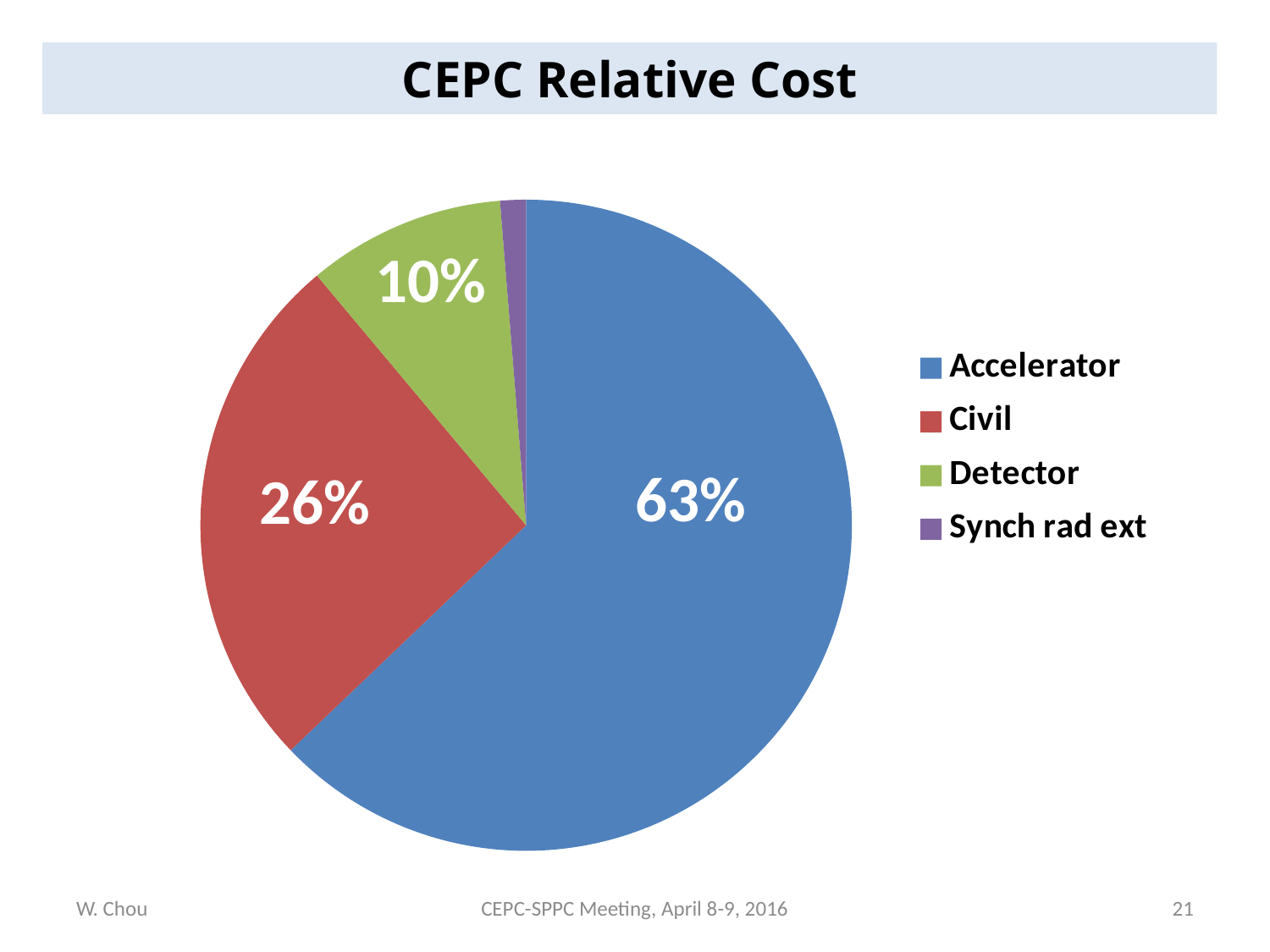
How many categories does the legend list? 4 What is the title of the chart? CEPC Relative Cost What share of the pie is labelled for Civil? 26% What is the difference in percentage points between the Civil and Detector slices? 16 Which category has the largest slice of the pie? Accelerator What kind of chart is shown on the slide? Pie chart What is the difference in percentage points between the Accelerator and Civil slices? 37 What share of the CEPC relative cost does the Accelerator slice represent? 63% Which colour represents the Detector category in the legend? Green Which is larger, the Civil slice or the Detector slice? Civil What percentage is shown for the Detector slice? 10% Which category has the smallest slice of the pie? Synch rad ext